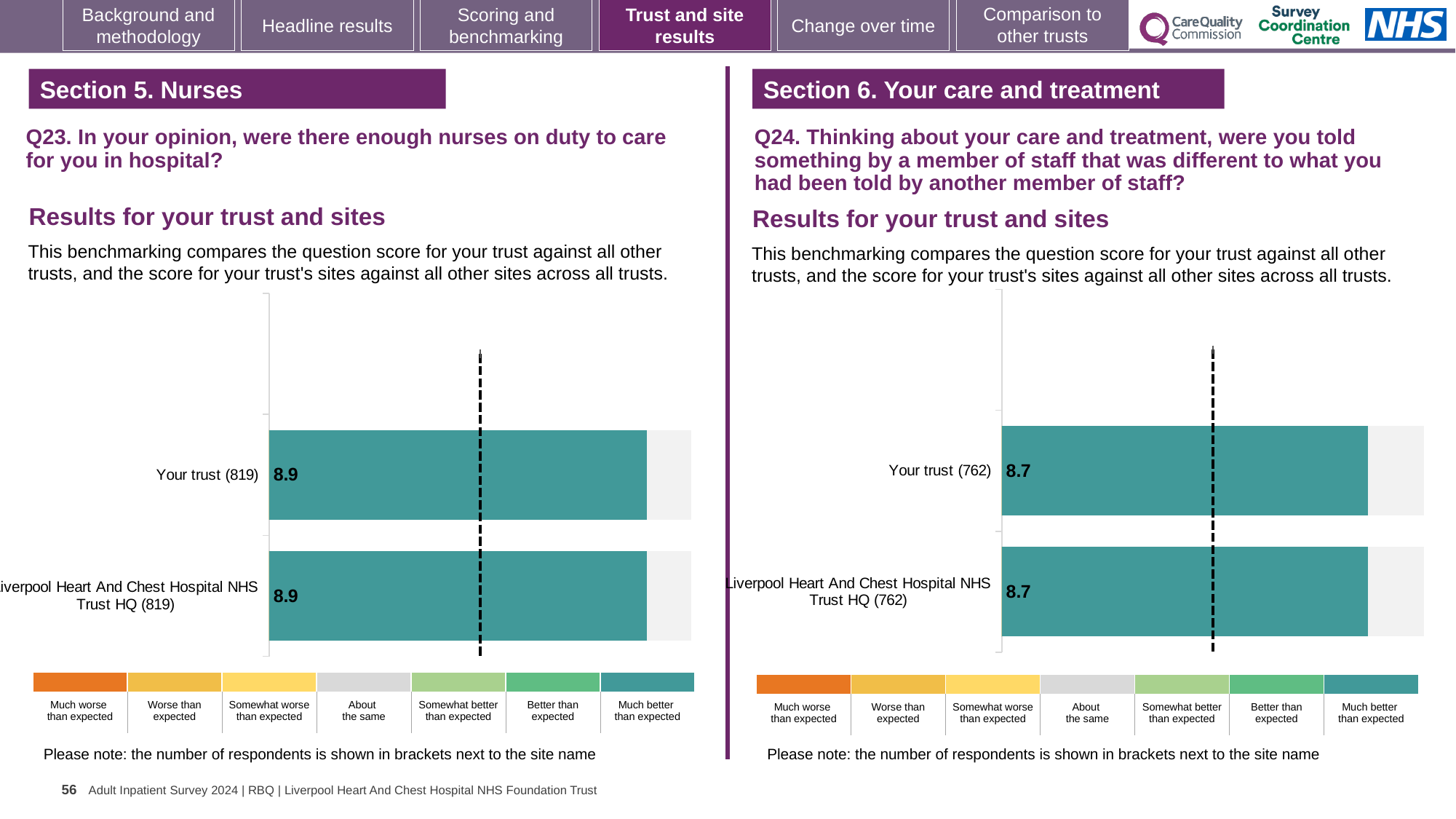
Which is larger: the Your trust score on the Q23 chart (left) or the Your trust score on the Q24 chart (right)? Q23 chart (left) How many respondents are shown in brackets for Your trust on the Q24 chart (right)? 762 How many bars are plotted on the Q24 chart (right)? 2 On the Q23 chart (left), what is the difference between the score for Your trust and the score for Liverpool Heart And Chest Hospital NHS Trust HQ? 0.0 What type of chart is used on the Q23 chart (left)? Bar chart On the Q24 chart (right), what is the score for Your trust (762)? 8.7 How many bars are plotted on the Q23 chart (left)? 2 On the Q23 chart (left), what is the score for Liverpool Heart And Chest Hospital NHS Trust HQ (819)? 8.9 On the Q23 chart (left), which benchmark category does the colour of the plotted bars correspond to in the legend below the chart? Much better than expected On the Q24 chart (right), what is the difference between the score for Your trust and the score for Liverpool Heart And Chest Hospital NHS Trust HQ? 0.0 On the Q24 chart (right), what is the score for Liverpool Heart And Chest Hospital NHS Trust HQ (762)? 8.7 On the Q23 chart (left), what is the score for Your trust (819)? 8.9